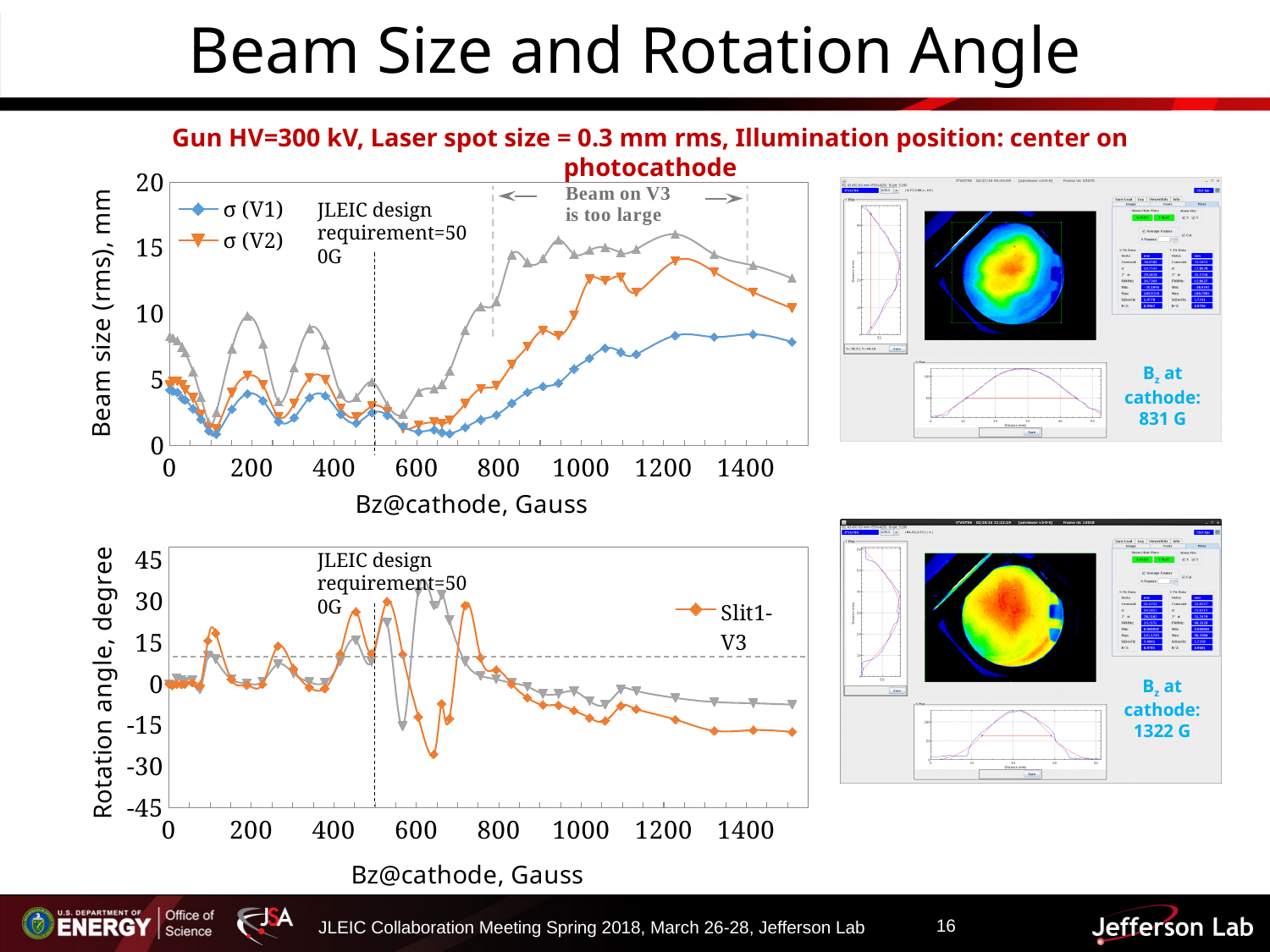
In the top chart (Beam size), which series has the larger value at 1200 Gauss, σ (V1) or σ (V2)? σ (V2) What is the y-axis title of the bottom chart? Rotation angle, degree In the top chart (Beam size), does σ (V1) rise or fall between 700 and 1200 Gauss? rise What is the x-axis title of the top chart? Bz@cathode, Gauss In the top chart (Beam size), is the value of σ (V2) at 1200 Gauss greater or less than 10? greater How many series does the legend of the bottom chart (Rotation angle) list? 1 In the bottom chart (Rotation angle), is the value of Slit1-V3 at 1400 Gauss greater or less than 0? less What kind of chart is the top chart (Beam size vs Bz@cathode)? line chart In the top chart (Beam size), is the value of σ (V1) at 600 Gauss greater or less than 5? less What kind of chart is the bottom chart (Rotation angle vs Bz@cathode)? line chart How many series does the legend of the top chart (Beam size) list? 2